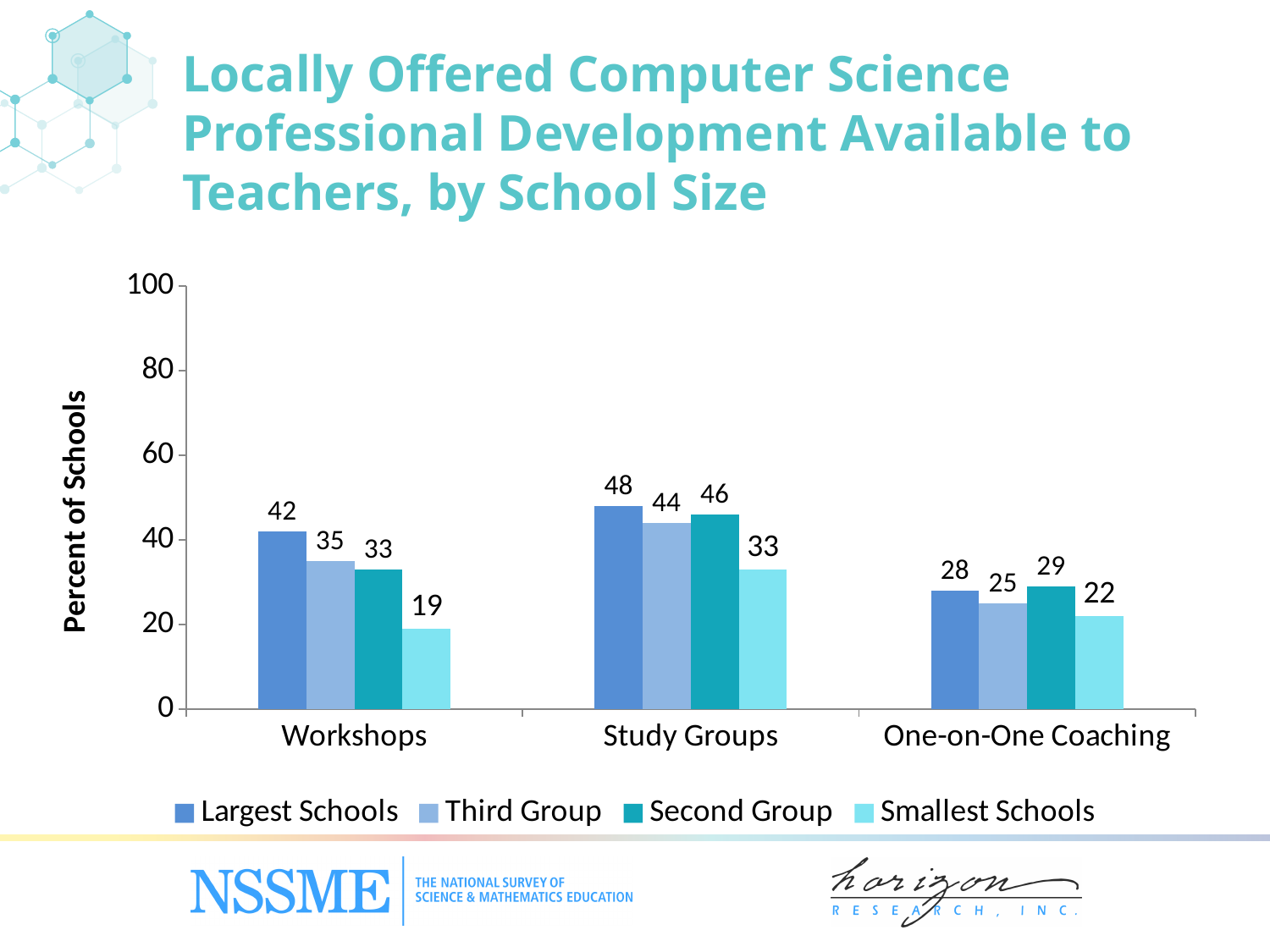
What is the value for Smallest Schools in the Study Groups category? 33 Which school size group has the highest value for Study Groups? Largest Schools What kind of chart is shown on the slide? Bar chart What percent of the largest schools offer workshops? 42 How many series does the legend list? 4 Which is larger for One-on-One Coaching: the Third Group value or the Second Group value? Second Group How many professional development categories are shown on the x axis? 3 Which school size group has the lowest value for Workshops? Smallest Schools What is the label of the y axis? Percent of Schools What is the value for Second Group in the One-on-One Coaching category? 29 Is the value for Largest Schools in Study Groups greater or less than 40? greater What is the difference between the Largest Schools and Smallest Schools values for Workshops? 23